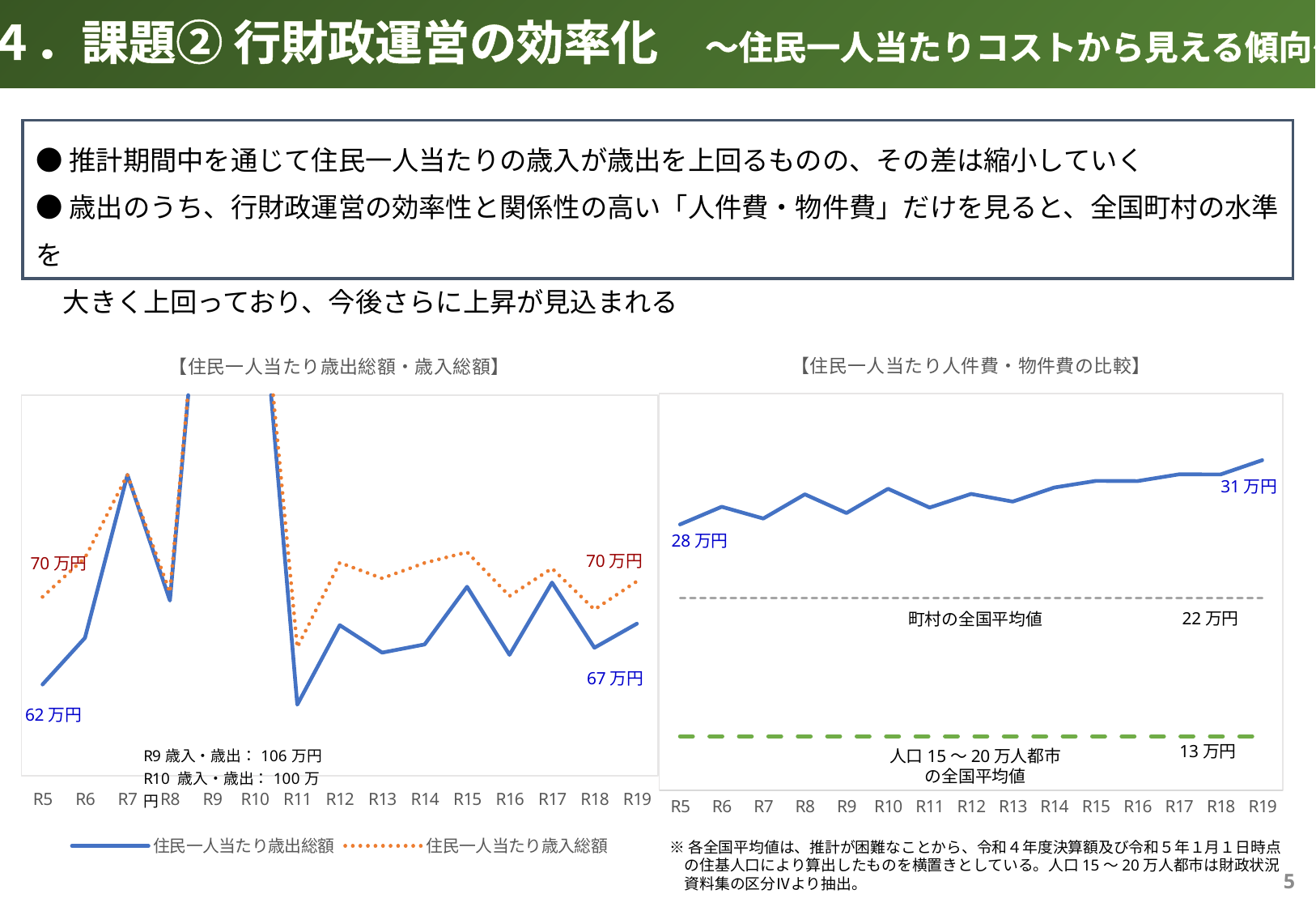
In the right chart 【住民一人当たり人件費・物件費の比較】, what is the value of the blue line at R5? 28万円 In the right chart 【住民一人当たり人件費・物件費の比較】, what is the difference between the R19 value of the blue line and 町村の全国平均値? 9万円 In the left chart 【住民一人当たり歳出総額・歳入総額】, what is the value of 住民一人当たり歳出総額 at R5? 62万円 In the left chart 【住民一人当たり歳出総額・歳入総額】, what is the difference between 歳入総額 and 歳出総額 at R5? 8万円 In the left chart 【住民一人当たり歳出総額・歳入総額】, what is the difference between 歳入総額 and 歳出総額 at R19? 3万円 In the left chart 【住民一人当たり歳出総額・歳入総額】, how many years are shown on the x axis? 15 In the right chart 【住民一人当たり人件費・物件費の比較】, what is the value of the blue line at R19? 31万円 In the left chart 【住民一人当たり歳出総額・歳入総額】, what is the value of 住民一人当たり歳入総額 at R19? 70万円 In the left chart 【住民一人当たり歳出総額・歳入総額】, what value is given for 歳入・歳出 at R9? 106万円 What kind of chart is the left chart titled 【住民一人当たり歳出総額・歳入総額】? line chart In the right chart 【住民一人当たり人件費・物件費の比較】, what is the value of 町村の全国平均値? 22万円 In the left chart 【住民一人当たり歳出総額・歳入総額】, how many series does the legend list? 2